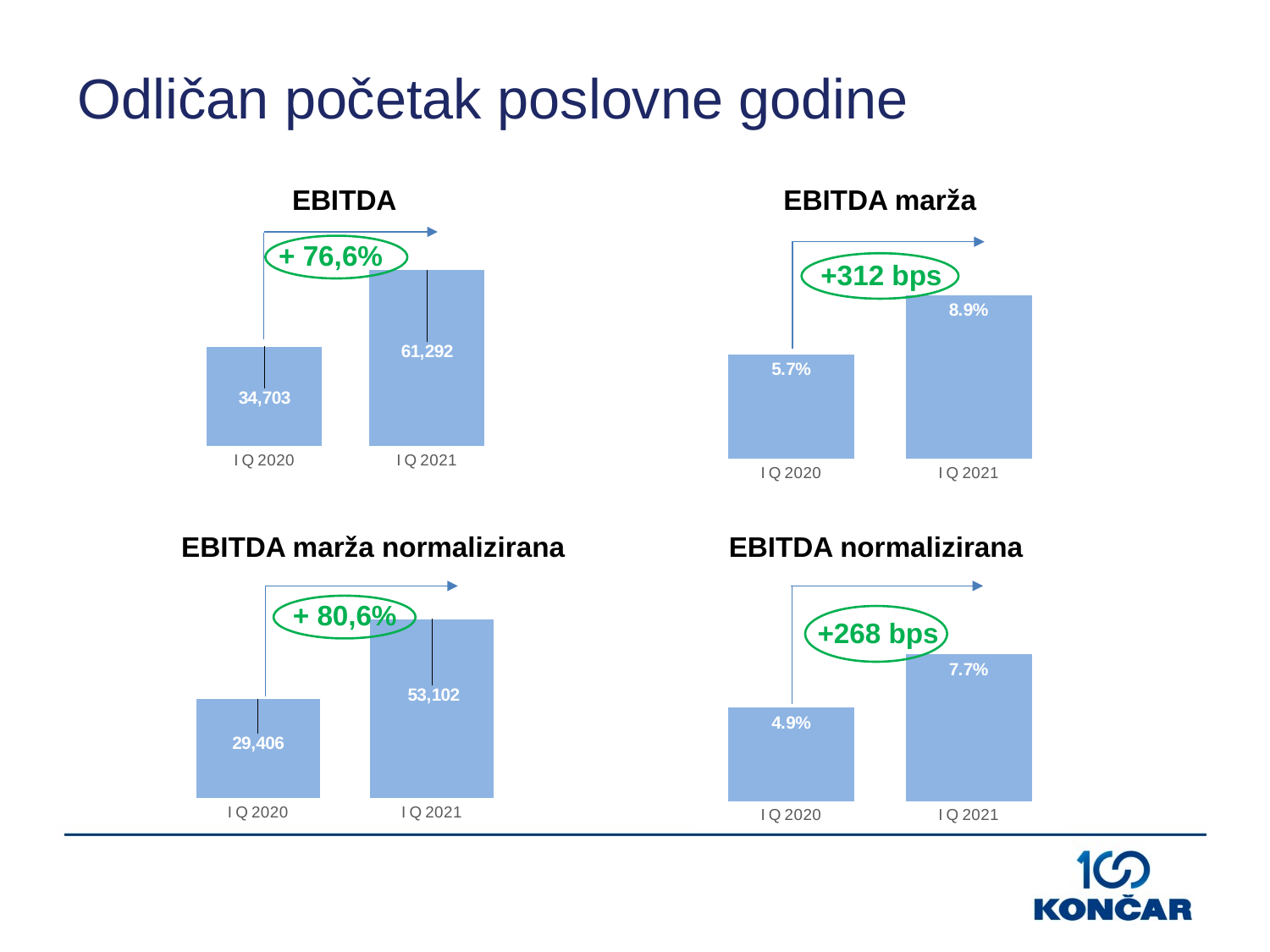
In the top-right chart titled EBITDA marža, what is the value for I Q 2020? 5.7% How many categories are shown on the x axis of the top-right chart titled EBITDA marža? 2 In the bottom-left chart titled EBITDA marža normalizirana, what is the value for I Q 2021? 53,102 In the bottom-left chart titled EBITDA marža normalizirana, which period has the lower value? I Q 2020 What percentage change is shown in the green oval on the top-left chart titled EBITDA? + 76,6% In the top-left chart titled EBITDA, what is the value for I Q 2020? 34,703 In the bottom-right chart titled EBITDA normalizirana, what is the value for I Q 2020? 4.9% In the bottom-right chart titled EBITDA normalizirana, which period has the higher value? I Q 2021 In the top-left chart titled EBITDA, what is the difference between the I Q 2021 and I Q 2020 values? 26,589 In the top-right chart titled EBITDA marža, what is the value for I Q 2021? 8.9% In the top-left chart titled EBITDA, what is the value for I Q 2021? 61,292 What kind of chart is the top-left chart titled EBITDA? bar chart